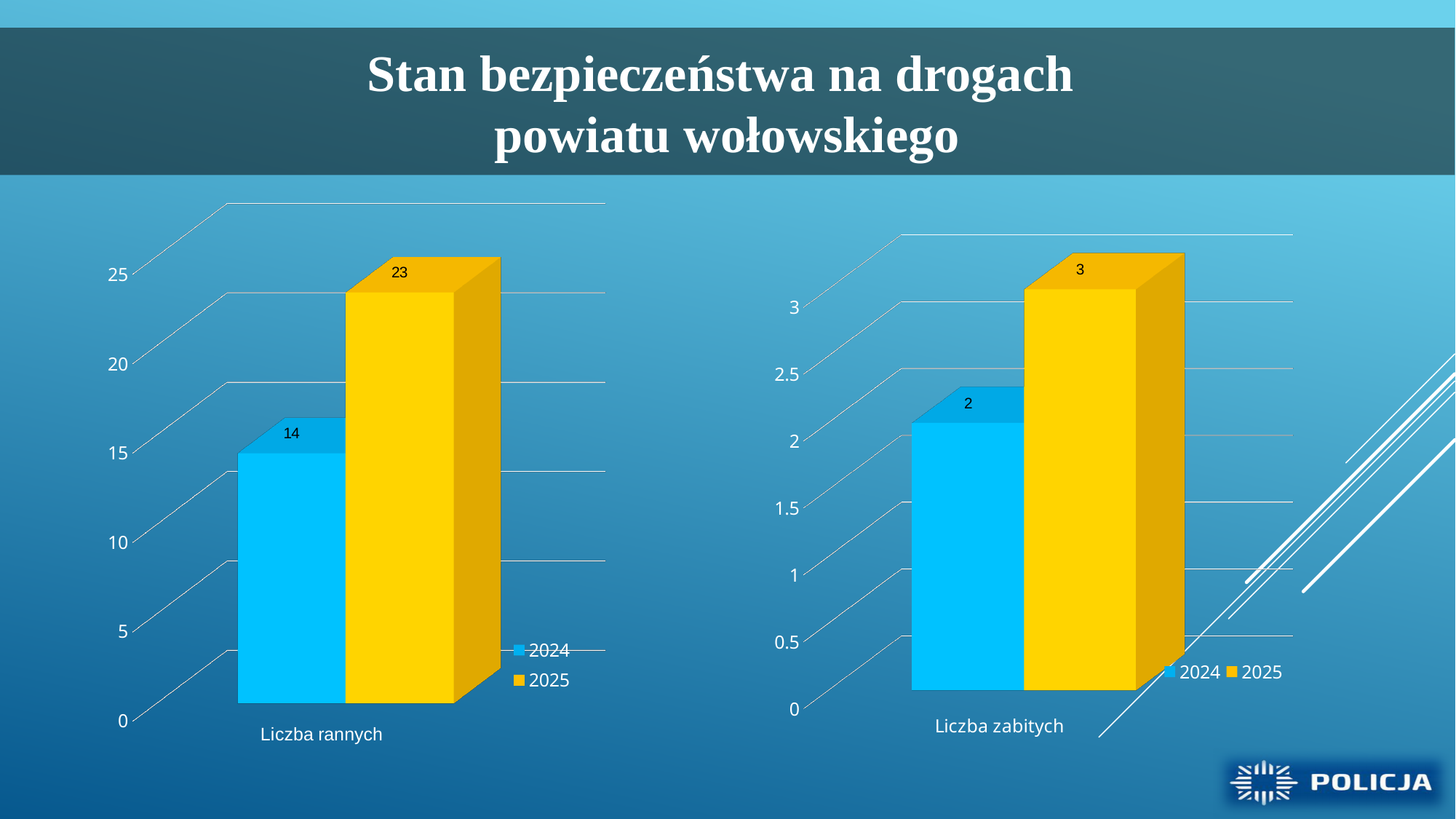
What colour represents the 2025 series in both charts? yellow In the left chart (Liczba rannych), is the value for 2025 greater or less than 20? greater In the left chart (Liczba rannych), what is the difference between the 2025 and 2024 values? 9 In the right chart (Liczba zabitych), what is the difference between the 2025 and 2024 values? 1 In the right chart (Liczba zabitych), what is the value for 2024? 2 In the left chart (Liczba rannych), what is the value for 2025? 23 In the left chart (Liczba rannych), what is the value for 2024? 14 In the left chart (Liczba rannych), which year has the higher value? 2025 What kind of chart is the right chart (Liczba zabitych)? bar chart In the right chart (Liczba zabitych), which year has the lower value? 2024 In the right chart (Liczba zabitych), what is the value for 2025? 3 How many series does the legend of the left chart (Liczba rannych) list? 2